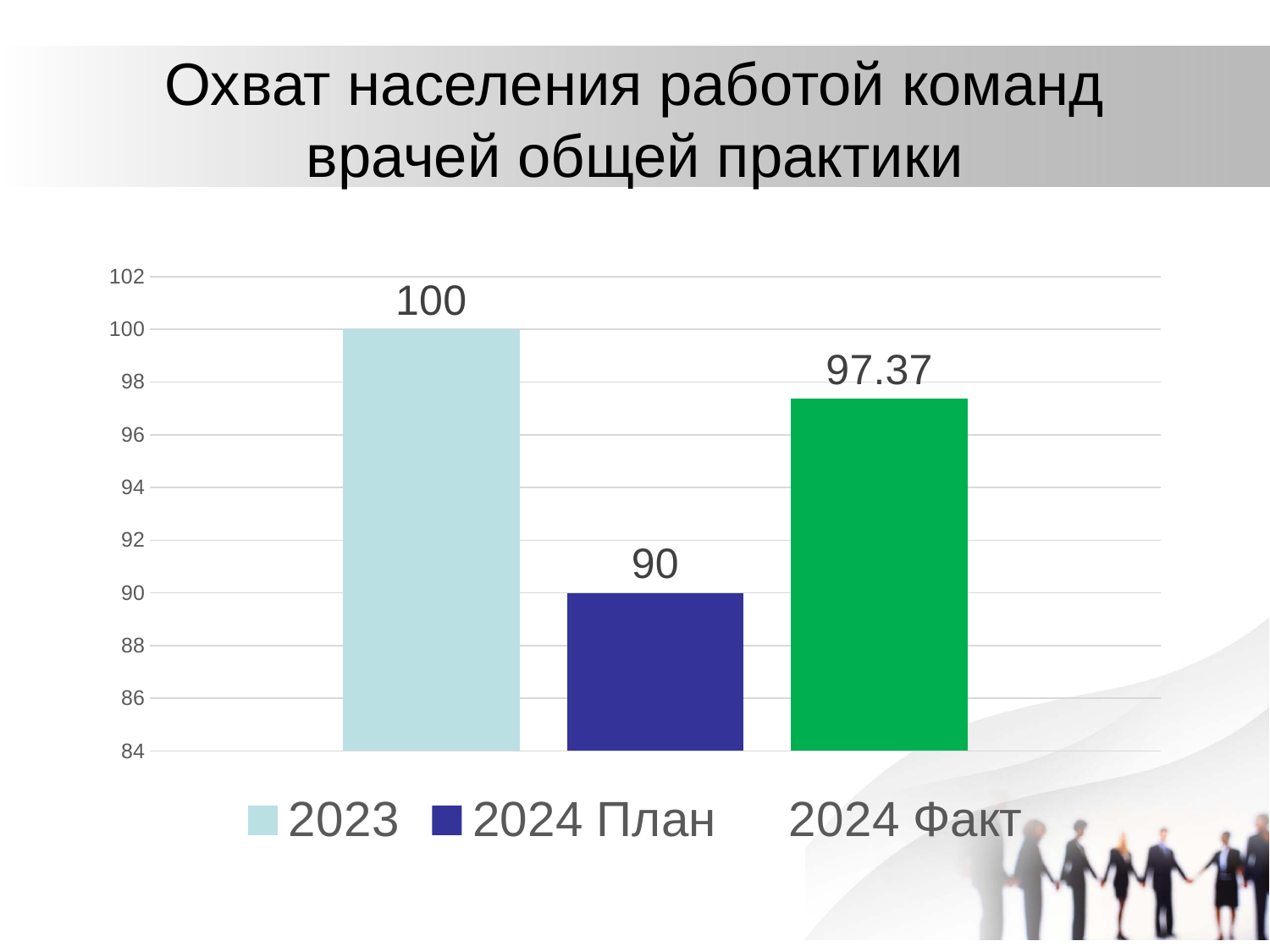
What is the value for 2024 Факт? 97.37 Which series has the highest value? 2023 What is the difference between the 2024 Факт value and the 2024 План value? 7.37 Is the value for 2024 Факт greater or less than 96? greater How many series does the legend list? 3 Which series has the lowest value? 2024 План How many bars are plotted on the chart? 3 Which is larger, the value for 2024 Факт or the value for 2024 План? 2024 Факт What is the value for 2023? 100 What is the difference between the 2023 value and the 2024 План value? 10 What kind of chart is shown on the slide? bar chart What is the value for 2024 План? 90